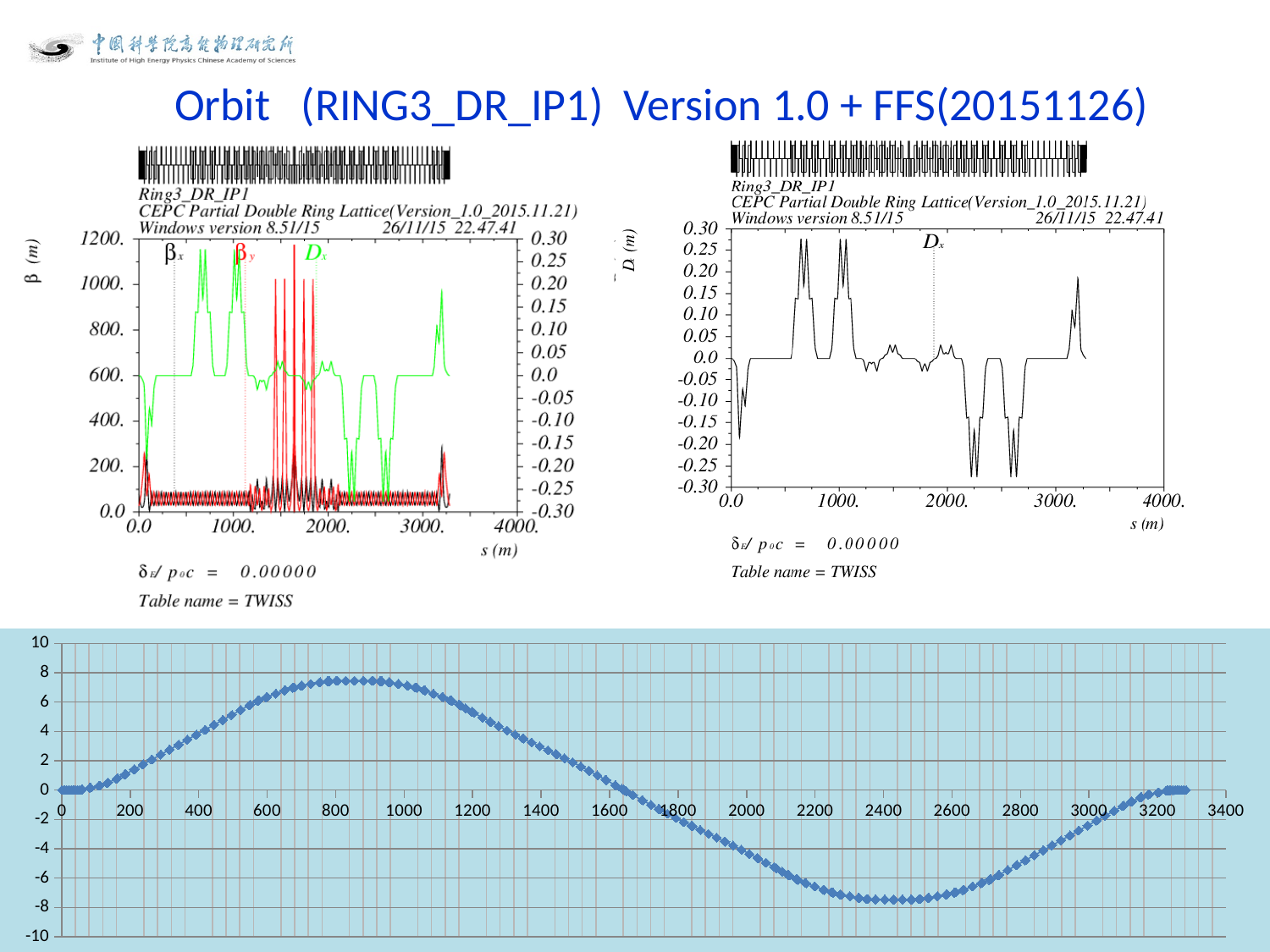
In the top-right chart, is the peak value of Dx near s = 700 greater or less than 0.20? greater In the bottom chart, is the value at x = 800 greater or less than 6? greater In the bottom chart, is the value at x = 2400 greater or less than -6? less How many data series are plotted in the bottom chart? 1 In the top-left chart, which three curves are labelled in the legend? βx, βy, Dx What kind of chart is the bottom chart on the slide? scatter chart with diamond markers In the bottom chart, do the values rise or fall as x goes from 1000 to 2400? fall In the bottom chart, do the values rise or fall as x goes from 0 to 800? rise In the bottom chart, is the value at x = 800 larger or smaller than the value at x = 2400? larger